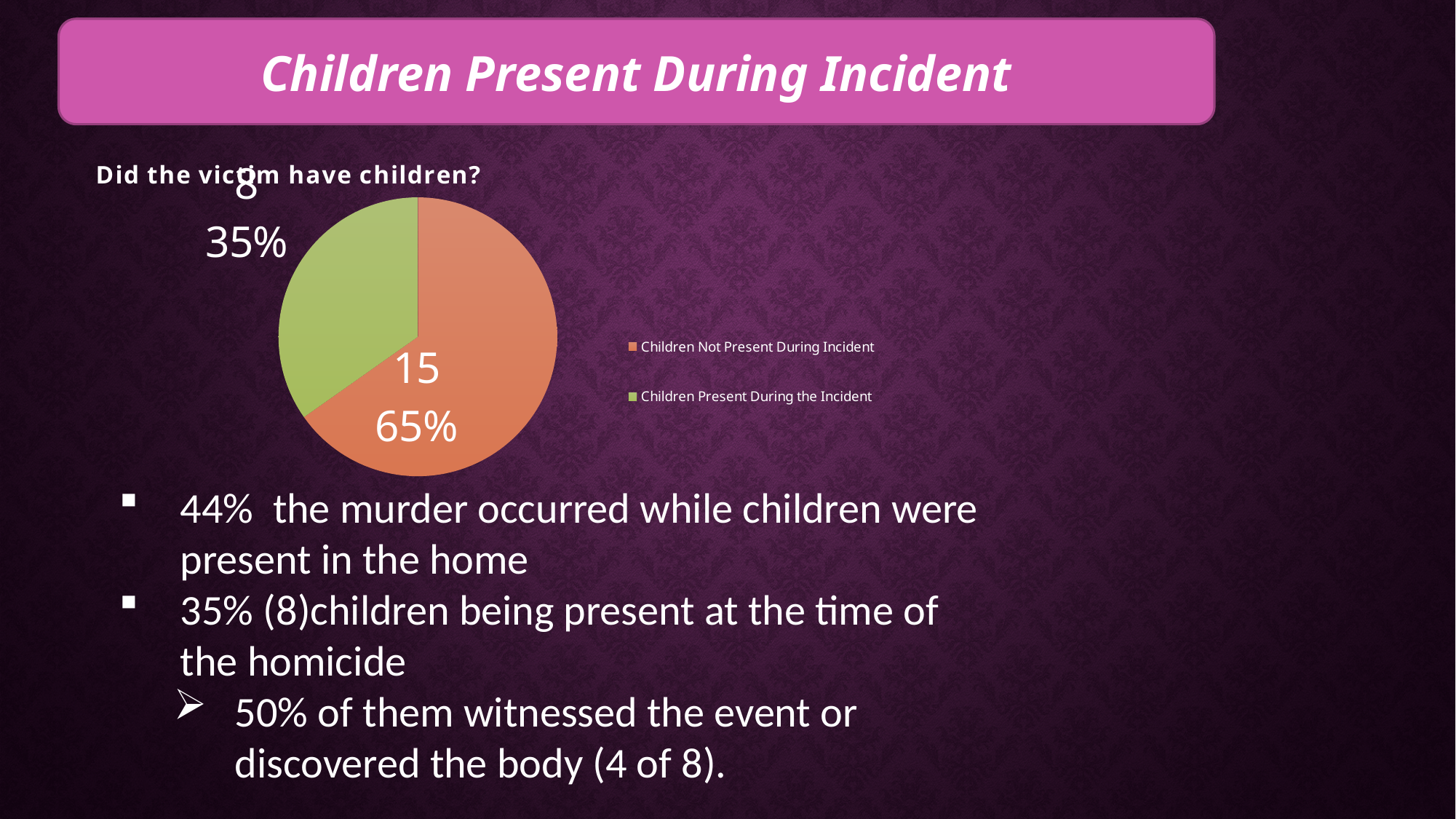
Which is larger: the value for 'Children Not Present During Incident' or 'Children Present During the Incident'? Children Not Present During Incident What percentage of the pie does the 'Children Not Present During Incident' slice represent? 65% What is the value shown for the 'Children Not Present During Incident' slice? 15 What is the difference between the values for 'Children Not Present During Incident' and 'Children Present During the Incident'? 7 What percentage of the pie does the 'Children Present During the Incident' slice represent? 35% What kind of chart is shown on the slide? pie chart Which slice of the pie chart is the largest? Children Not Present During Incident What is the total of the two values shown on the pie chart? 23 What colour is the 'Children Present During the Incident' slice? green What is the value shown for the 'Children Present During the Incident' slice? 8 Which slice of the pie chart is the smallest? Children Present During the Incident How many slices does the pie chart have? 2